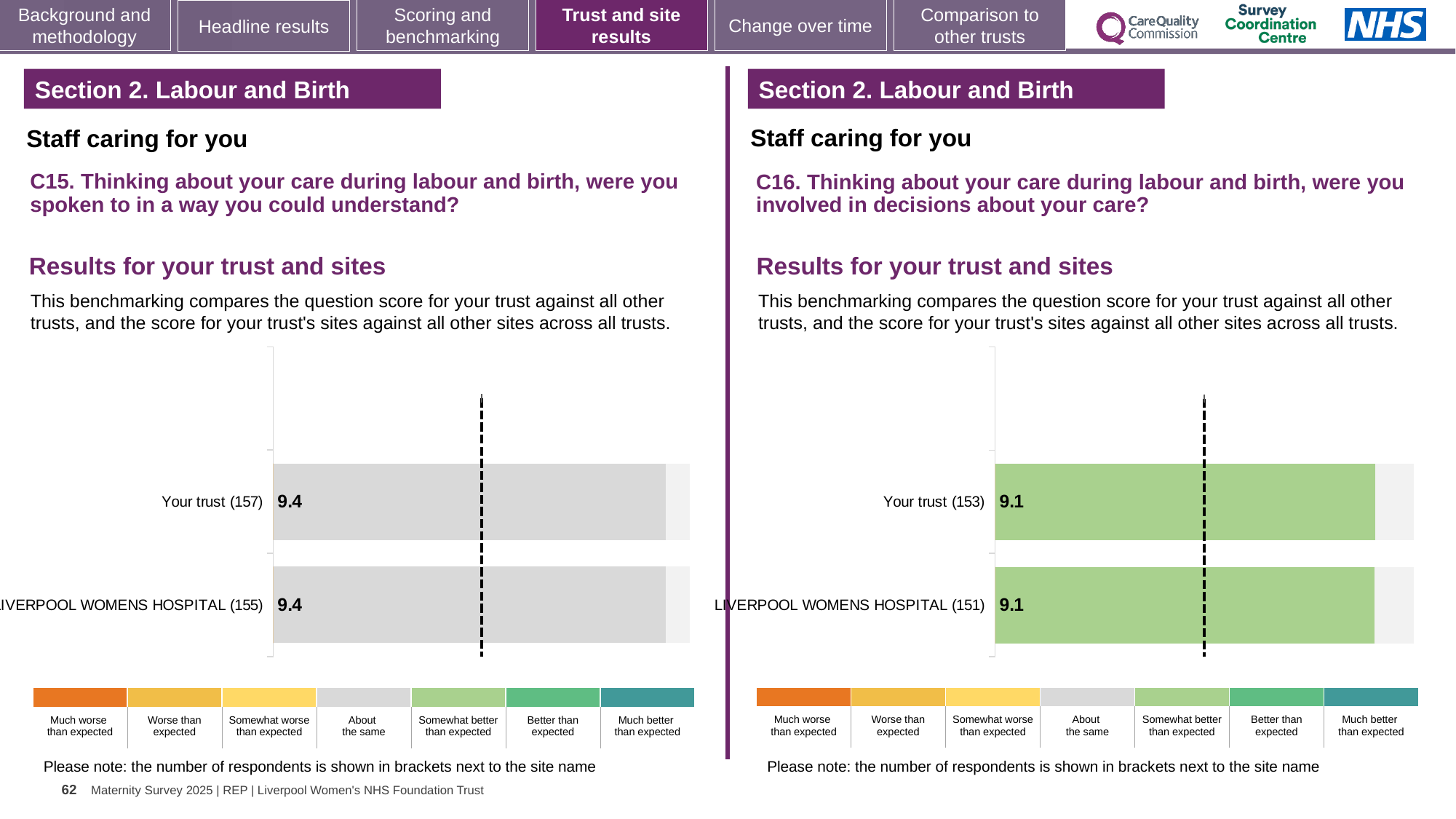
In the C15 chart on the left, what is the score for Your trust? 9.4 In the C16 chart on the right, what is the difference between the Your trust score and the LIVERPOOL WOMENS HOSPITAL score? 0 How many bars are plotted in the C16 chart on the right? 2 In the C16 chart on the right, which benchmark category does the green colour of the bars correspond to in the legend? Somewhat better than expected How many bars are plotted in the C15 chart on the left? 2 What type of chart is used for the C15 results on the left? Bar chart In the C16 chart on the right, what is the score for Your trust? 9.1 In the C15 chart on the left, how many respondents are shown in brackets for Your trust? 157 In the C16 chart on the right, how many respondents are shown in brackets for LIVERPOOL WOMENS HOSPITAL? 151 In the C15 chart on the left, what is the score for LIVERPOOL WOMENS HOSPITAL? 9.4 In the C16 chart on the right, what is the score for LIVERPOOL WOMENS HOSPITAL? 9.1 In the C15 chart on the left, what is the difference between the Your trust score and the LIVERPOOL WOMENS HOSPITAL score? 0